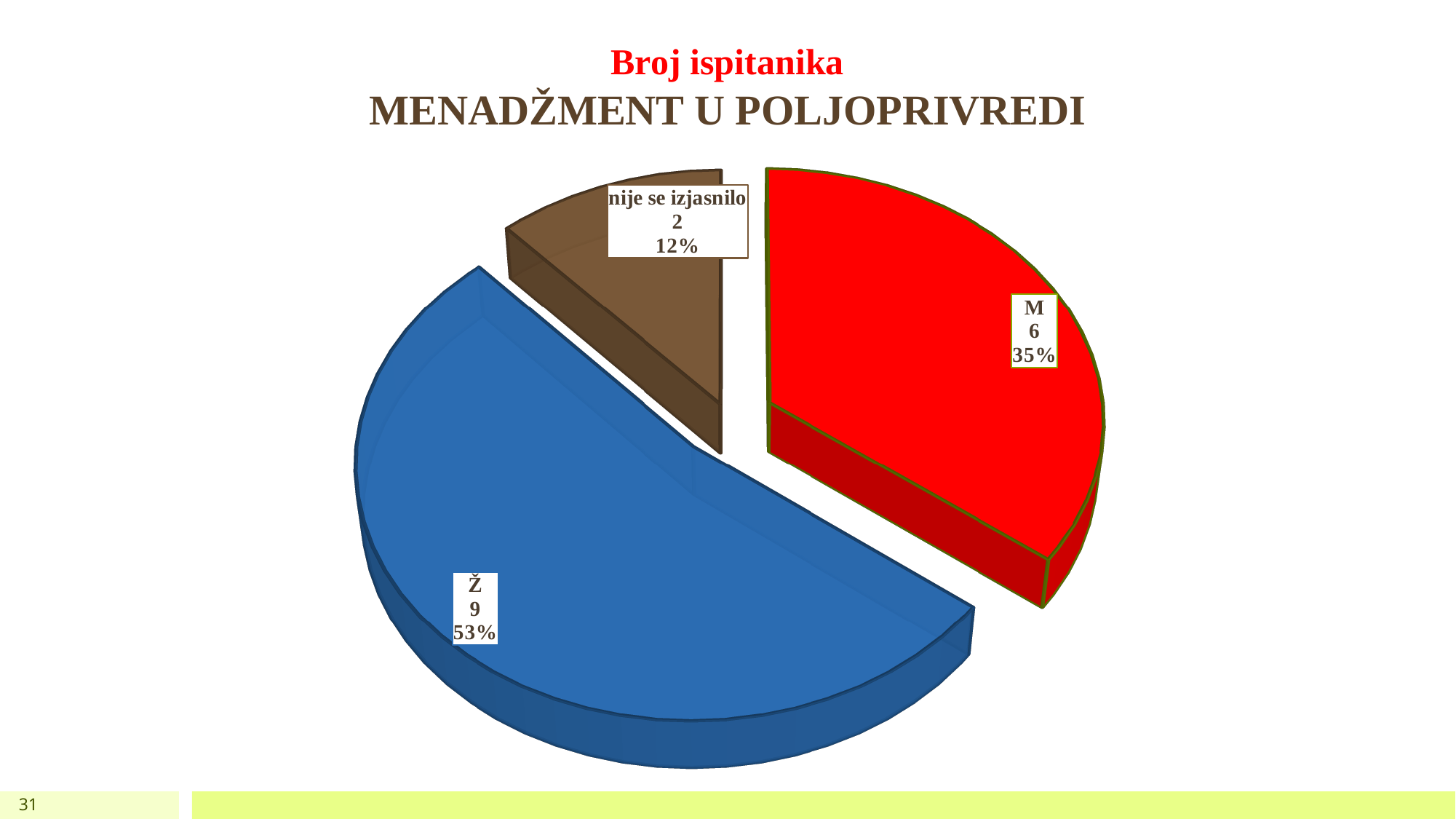
What share of the pie does the Ž slice represent? 53% What is the difference in the number of respondents between Ž and M? 3 Which category has more respondents, M or 'nije se izjasnilo'? M How many respondents are in the 'nije se izjasnilo' category? 2 Which category has the smallest number of respondents? nije se izjasnilo What kind of chart is shown on the slide? pie chart How many slices does the pie chart have? 3 How many respondents are in the M category? 6 Which category has the largest number of respondents? Ž How many respondents are in the Ž category? 9 What share of the pie does the 'nije se izjasnilo' slice represent? 12% What share of the pie does the M slice represent? 35%